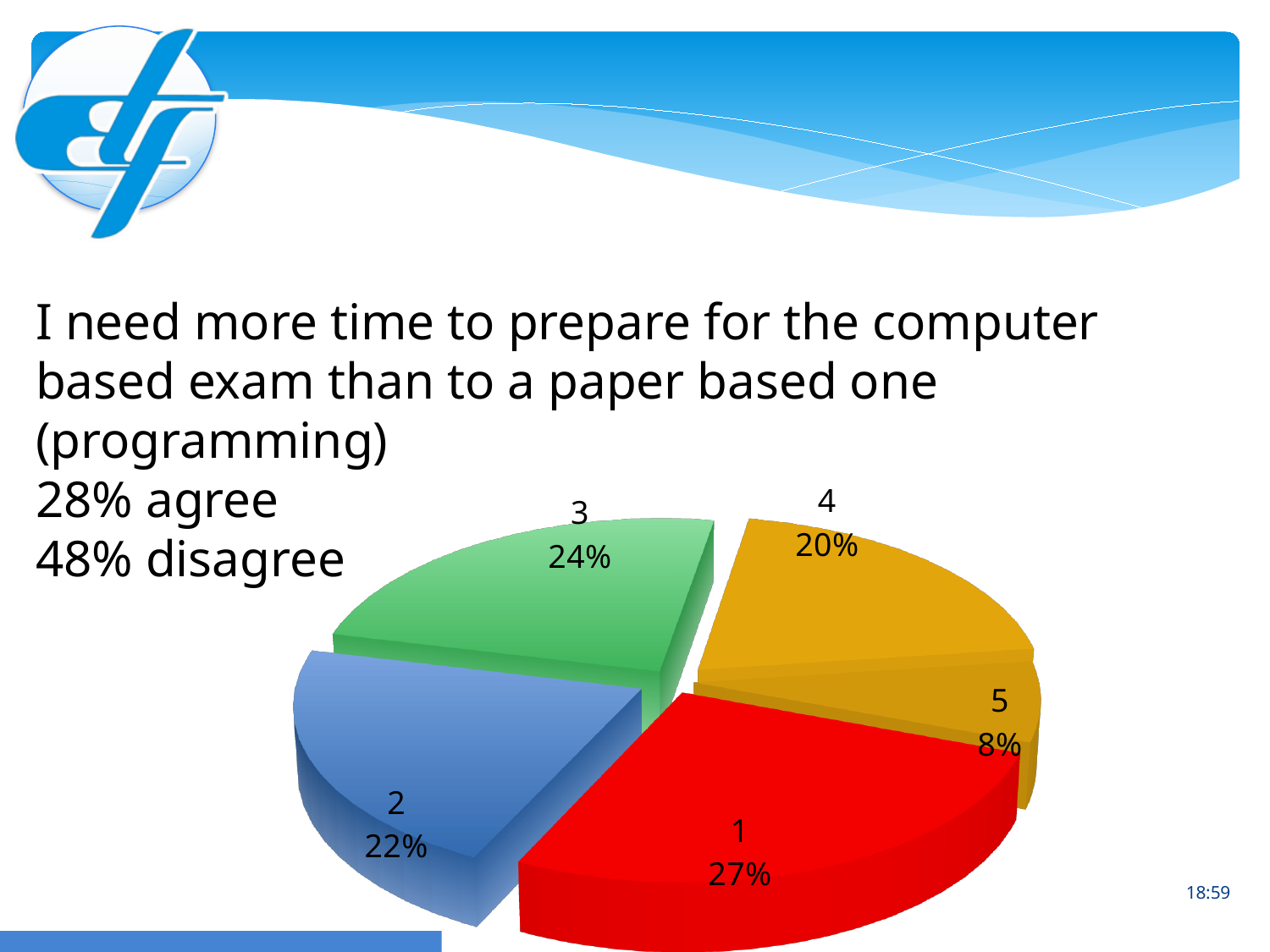
Which slice of the pie chart has the largest share? 1 What is the difference in percentage points between slice 1 and slice 2 in the pie chart? 5 What percentage is shown for slice 5 in the pie chart? 8% Which slice has a larger share in the pie chart, slice 3 or slice 4? 3 What percentage is shown for slice 2 in the pie chart? 22% What percentage is shown for slice 4 in the pie chart? 20% What percentage is shown for slice 1 in the pie chart? 27% What percentage is shown for slice 3 in the pie chart? 24% What colour is slice 1 in the pie chart? red Which slice of the pie chart has the smallest share? 5 How many slices does the pie chart have? 5 What kind of chart is shown on the slide? pie chart